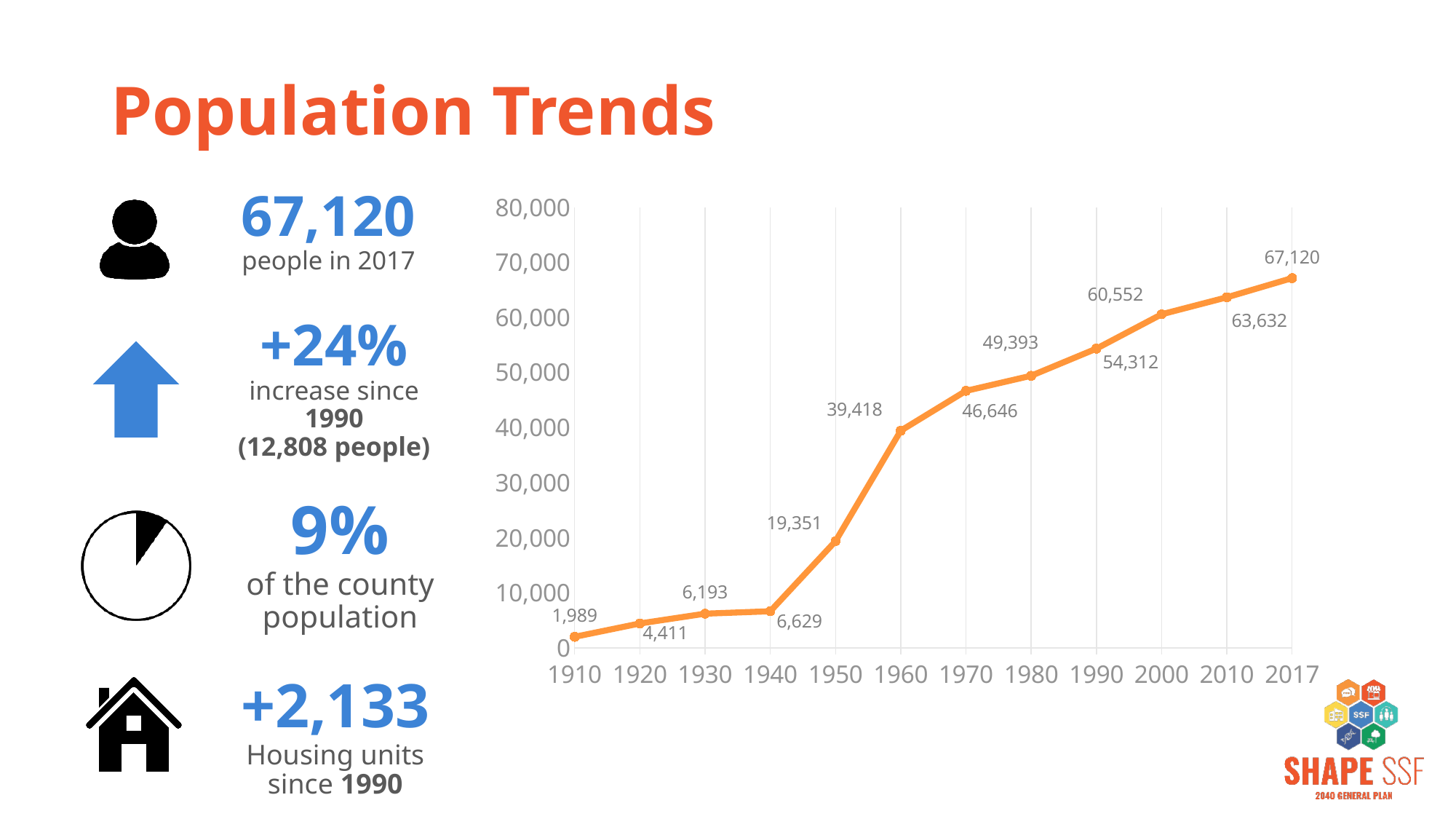
What is the population value plotted for 2000? 60,552 What is the population value plotted for 1910? 1,989 What kind of chart is shown on the slide? line chart What is the difference between the population in 2017 and the population in 2010? 3,488 Which year has the lowest plotted population? 1910 What is the difference between the population in 1960 and the population in 1950? 20,067 Does the plotted population rise or fall from 1910 to 2017? rise Which is larger, the population in 1930 or the population in 1940? 1940 How many years are plotted on the x axis of the chart? 12 Which year has the highest plotted population? 2017 What is the population value plotted for 1960? 39,418 Is the population value for 1970 greater or less than 40,000? greater